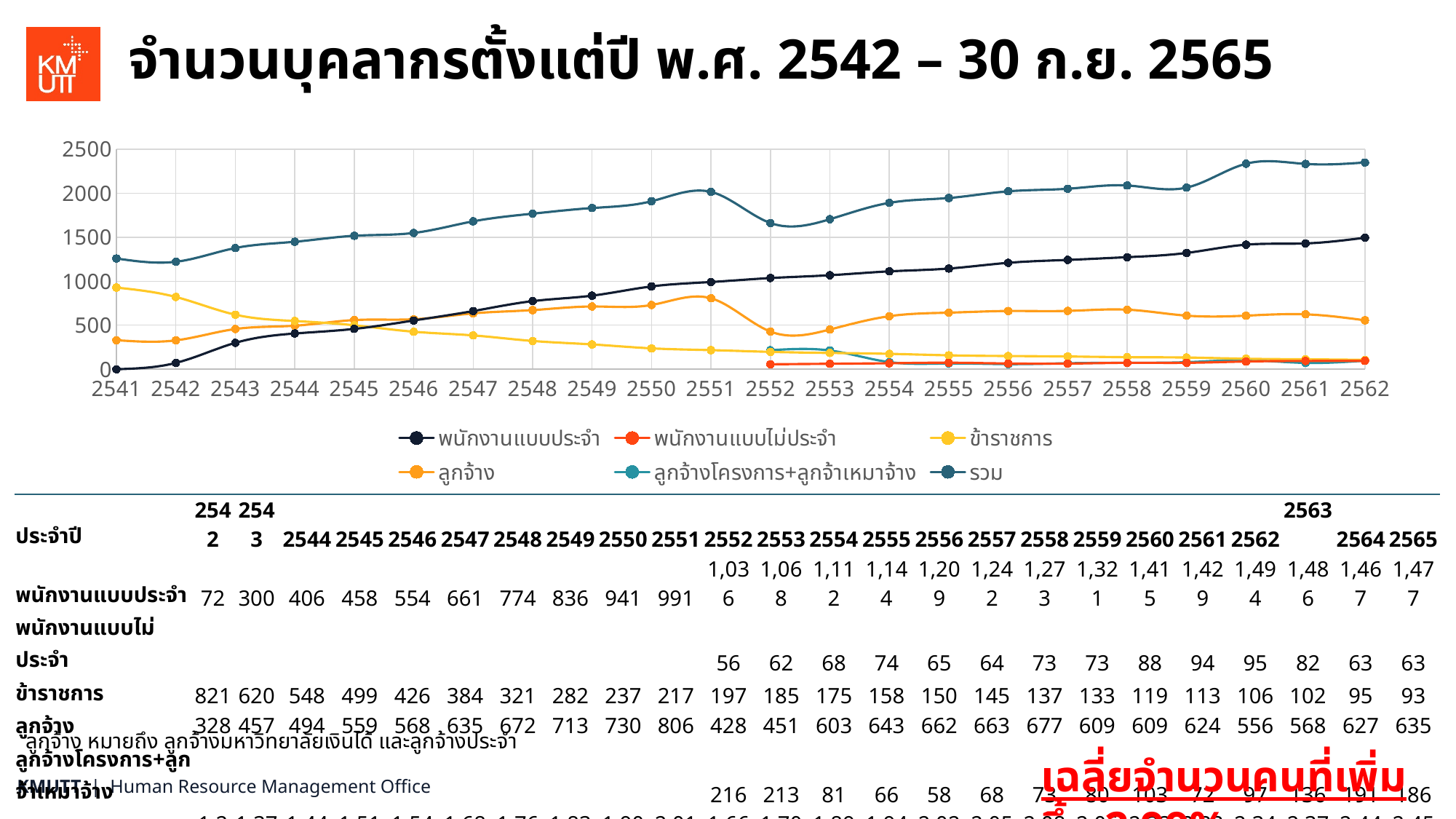
Is the value of ข้าราชการ at 2550 greater or less than 500? less How many years are labelled along the x axis of the chart? 22 According to the data table, what is the value of ลูกจ้าง for 2551? 806 According to the data table, what is the value of ข้าราชการ for 2542? 821 At 2549, which is larger: ลูกจ้าง or ข้าราชการ? ลูกจ้าง Which series has the highest value at 2562 in the chart? รวม Is the value of รวม at 2560 greater or less than 2000? greater Does the ข้าราชการ series rise or fall from 2542 to 2562? fall What kind of chart is shown on the slide? line chart How many series does the chart legend list? 6 Does the พนักงานแบบประจำ series rise or fall from 2542 to 2562? rise Which series has the lowest value at 2542 in the chart? พนักงานแบบประจำ